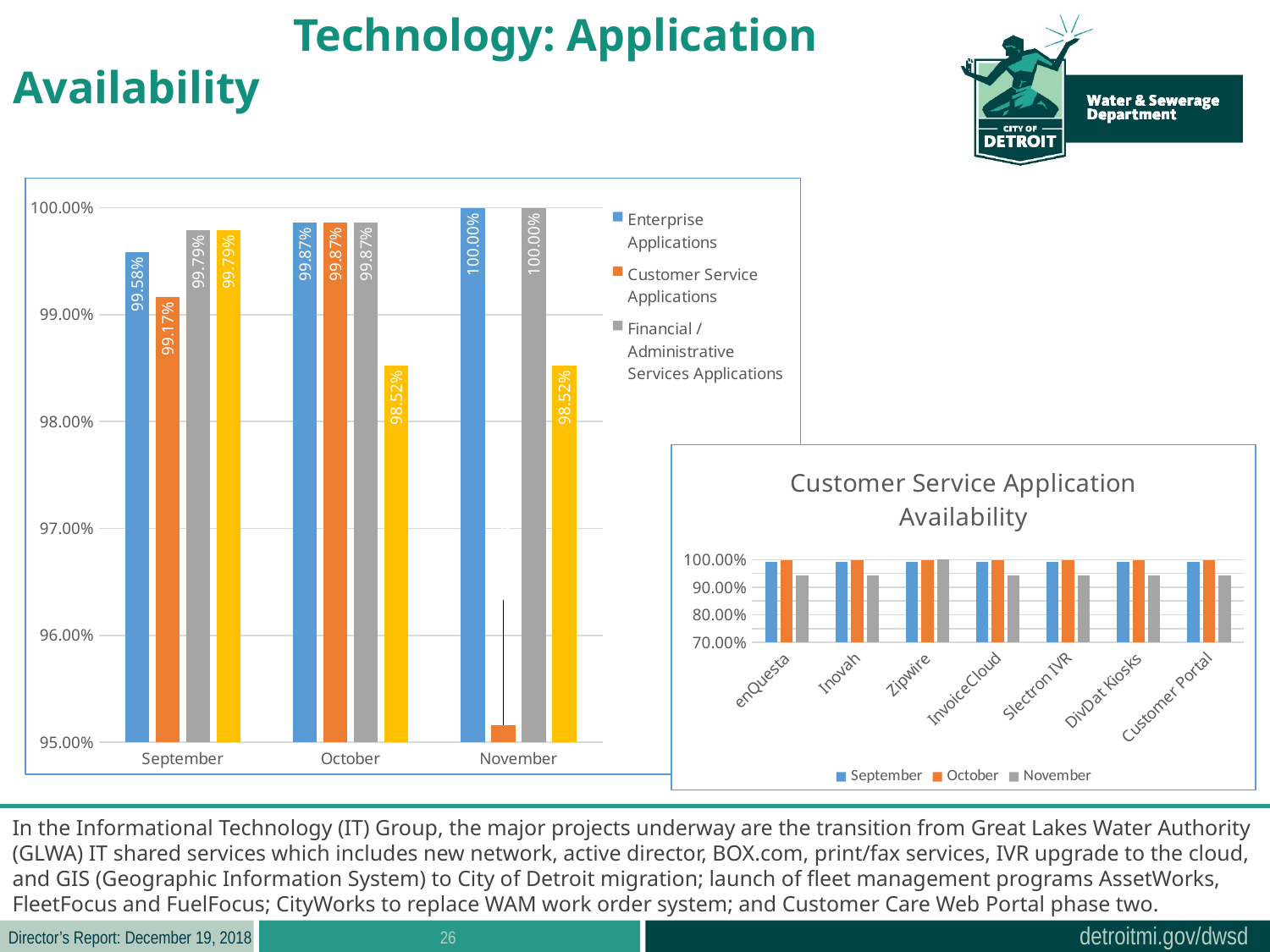
On the left chart, what is the value for Enterprise Applications in November? 100.00% On the left chart, what is the value for Customer Service Applications in September? 99.17% What kind of chart is the Customer Service Application Availability chart? bar chart On the Customer Service Application Availability chart, how many applications are shown on the x axis? 7 On the Customer Service Application Availability chart, how many series does the legend list? 3 On the left chart, what is the difference between the Enterprise Applications and Customer Service Applications values in September? 0.41% On the left chart, what is the value for Financial / Administrative Services Applications in October? 99.87% On the Customer Service Application Availability chart, is the November value for enQuesta greater or less than 100.00%? less On the left chart, which is larger in September: Enterprise Applications or Financial / Administrative Services Applications? Financial / Administrative Services Applications On the left chart, do the Enterprise Applications values rise or fall from September to November? rise On the left chart, how many series does the legend list? 3 On the left chart, what is the value for Enterprise Applications in September? 99.58%